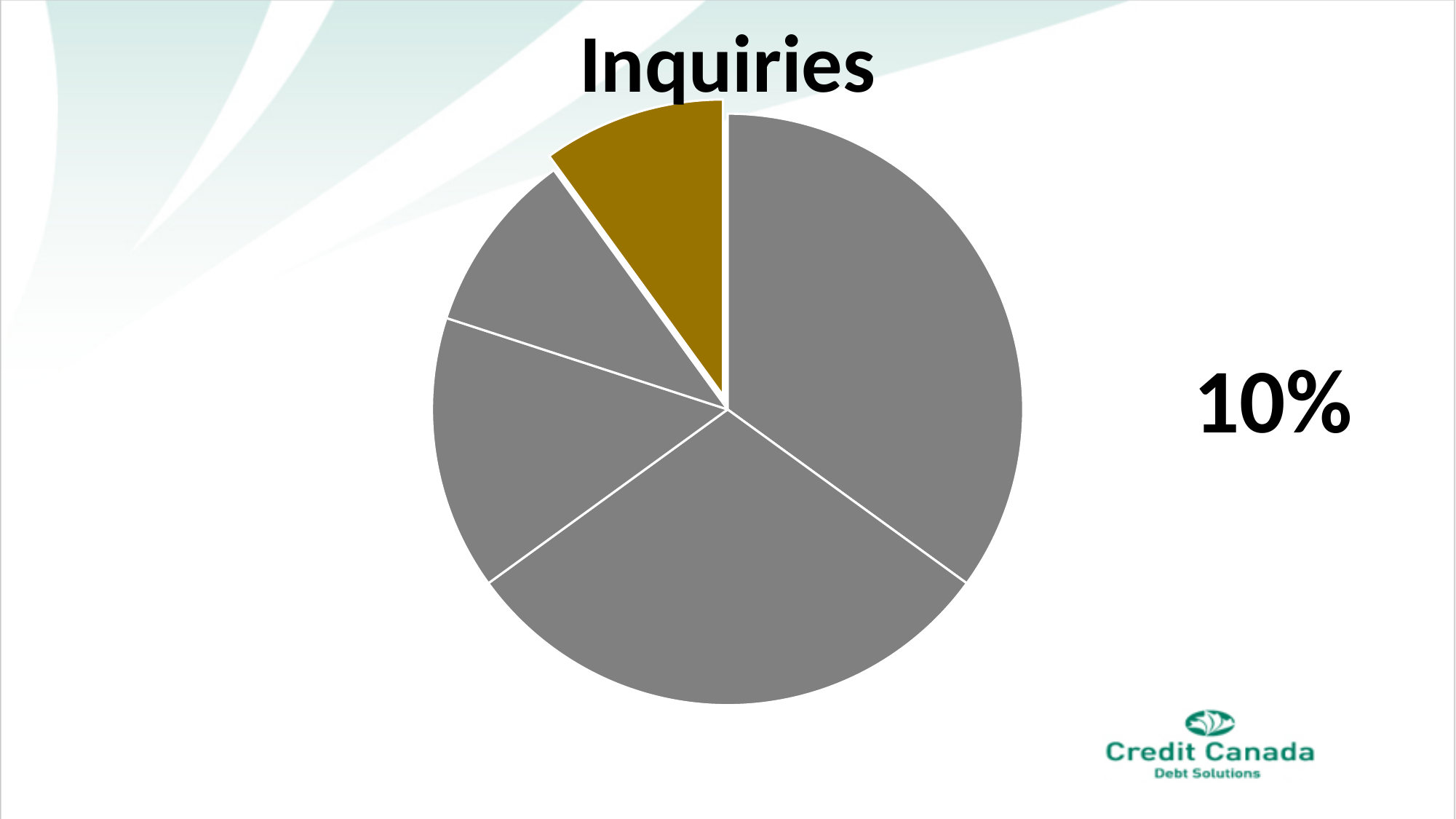
What colour is the exploded, highlighted slice of the pie chart? gold Is the highlighted gold slice the largest slice of the pie? No Is the highlighted gold slice's share greater or less than 50%? less What share of the pie does the highlighted (gold) slice represent, according to the percentage shown on the slide? 10% What kind of chart is shown on the slide? pie chart How many slices does the pie chart have? 5 What is the title of the chart? Inquiries